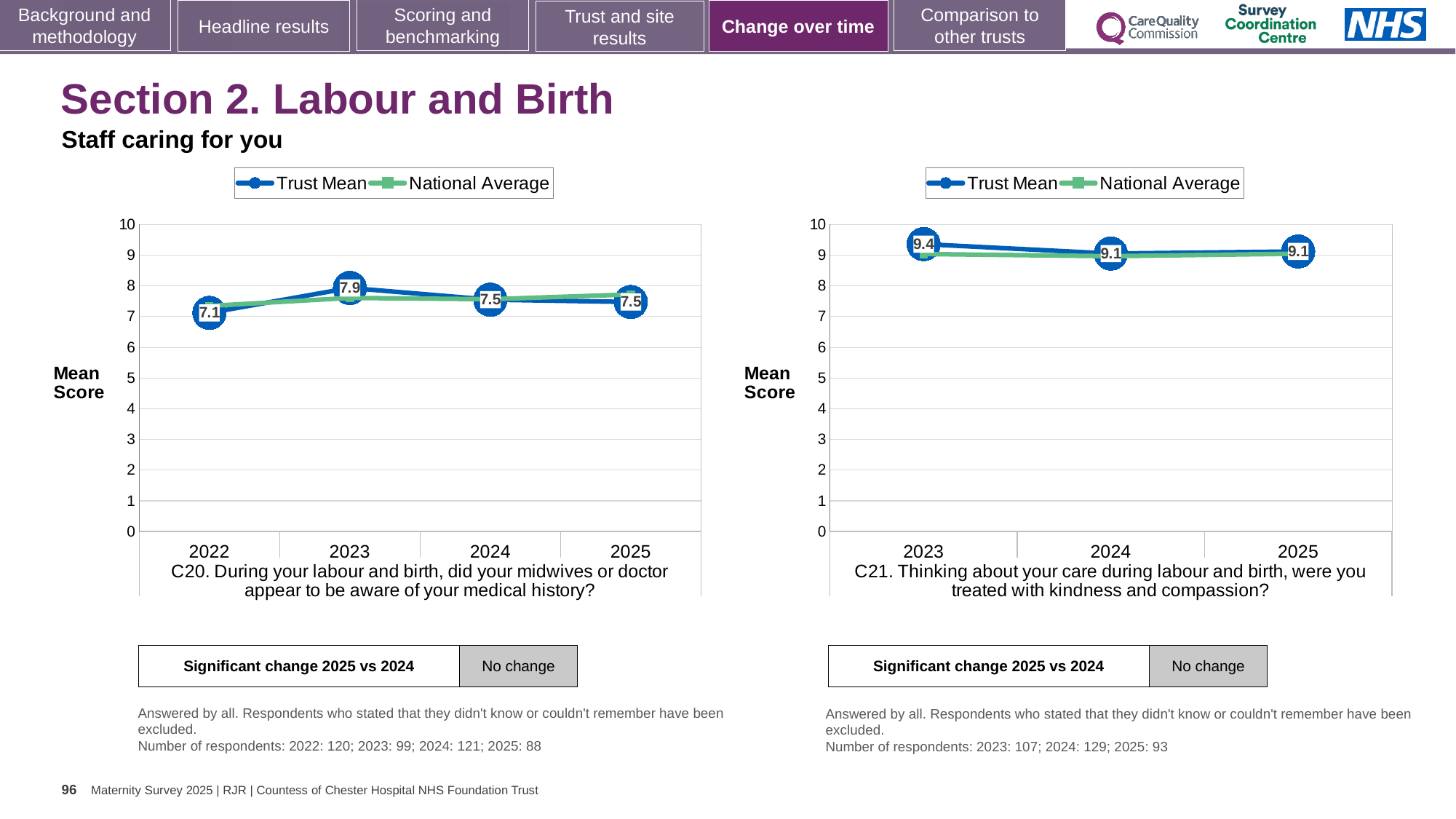
In the left chart (C20), which year has the lowest Trust Mean score? 2022 In the right chart (C21), does the Trust Mean score rise or fall from 2023 to 2024? Fall In the left chart (C20), what is the Trust Mean score for 2023? 7.9 In the left chart (C20), what is the Trust Mean score for 2022? 7.1 What kind of chart is the right chart (C21)? Line chart In the left chart (C20), which year has the highest Trust Mean score? 2023 In the right chart (C21), is the Trust Mean score for 2023 greater or less than 9? greater In the left chart (C20), what is the difference between the Trust Mean scores for 2023 and 2022? 0.8 In the right chart (C21), what is the Trust Mean score for 2025? 9.1 In the right chart (C21), what is the Trust Mean score for 2023? 9.4 In the right chart (C21), how many series does the legend list? 2 In the left chart (C20), how many years are plotted on the x axis? 4